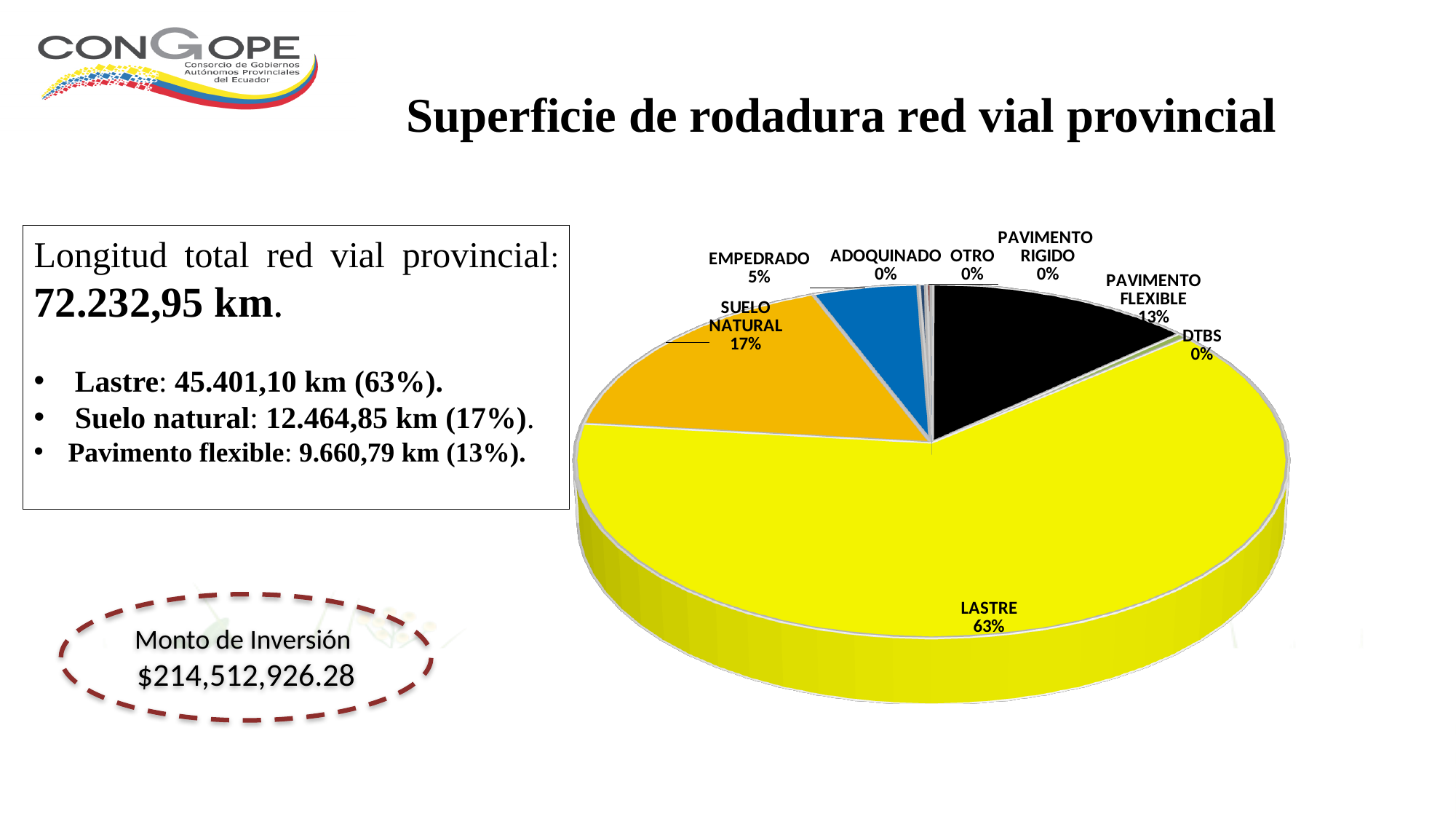
What colour is the LASTRE slice of the pie? yellow What kind of chart is shown on the slide? pie chart What share of the pie does LASTRE represent? 63% Which category has the largest slice of the pie? LASTRE Which is larger, the share for SUELO NATURAL or the share for PAVIMENTO FLEXIBLE? SUELO NATURAL What is the difference in percentage points between PAVIMENTO FLEXIBLE and EMPEDRADO? 8 What share of the pie does EMPEDRADO represent? 5% What share of the pie does SUELO NATURAL represent? 17% How many categories are labelled on the pie chart? 8 What percentage is shown for DTBS? 0% What is the difference in percentage points between LASTRE and SUELO NATURAL? 46